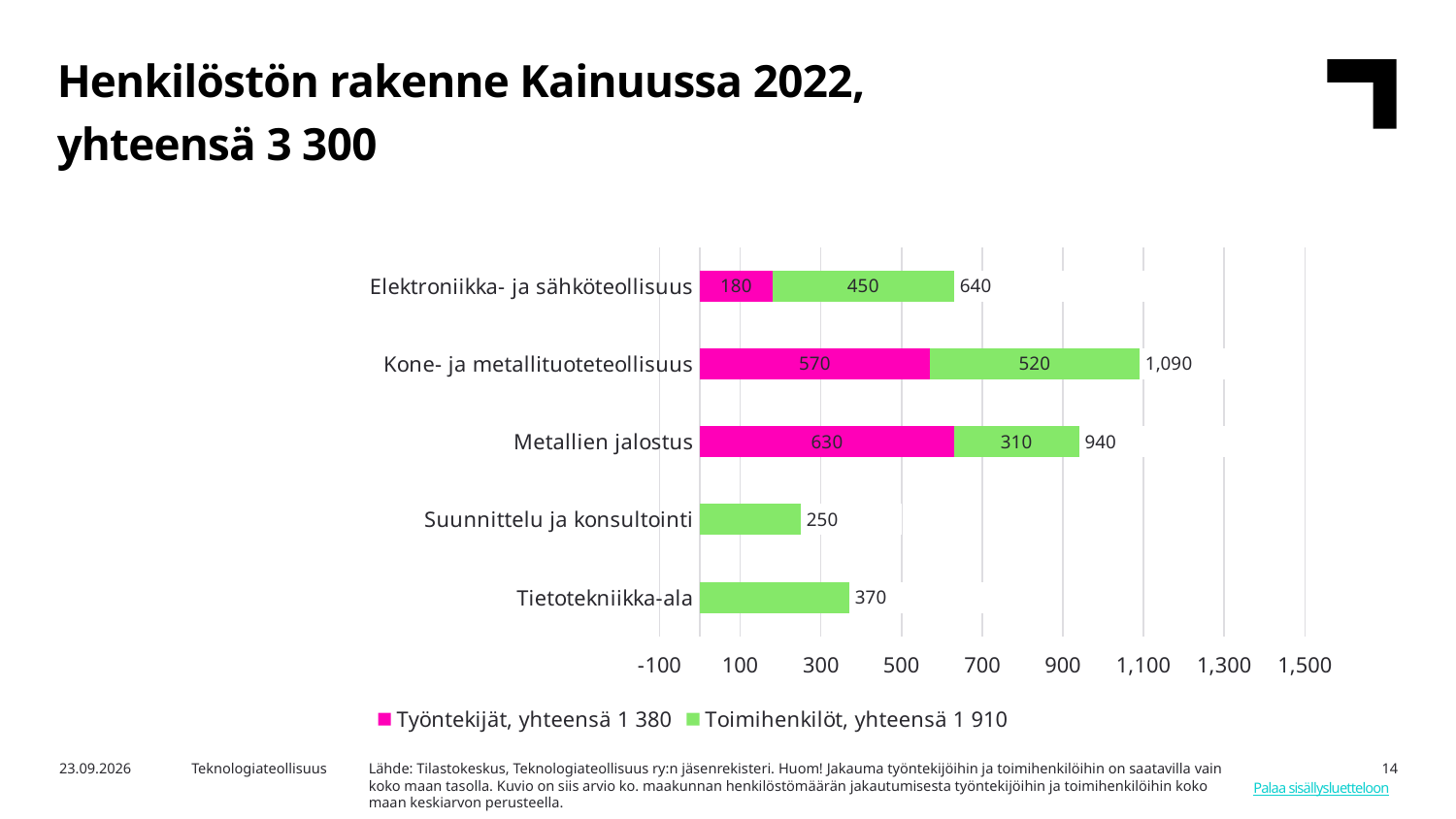
What is the total shown for the Metallien jalostus bar? 940 What is the difference between the Työntekijät values for Metallien jalostus and Elektroniikka- ja sähköteollisuus? 450 Which category has the highest total? Kone- ja metallituoteteollisuus What is the Toimihenkilöt value for Elektroniikka- ja sähköteollisuus? 450 What is the total shown for the Kone- ja metallituoteteollisuus bar? 1,090 What kind of chart is shown on the slide? Stacked bar chart Which colour represents the Työntekijät series? Pink (magenta) Which category has the lowest total? Suunnittelu ja konsultointi Which is larger: the Toimihenkilöt value for Tietotekniikka-ala or for Suunnittelu ja konsultointi? Tietotekniikka-ala How many categories are shown on the chart? 5 How many series does the legend list? 2 What is the Työntekijät value for Kone- ja metallituoteteollisuus? 570